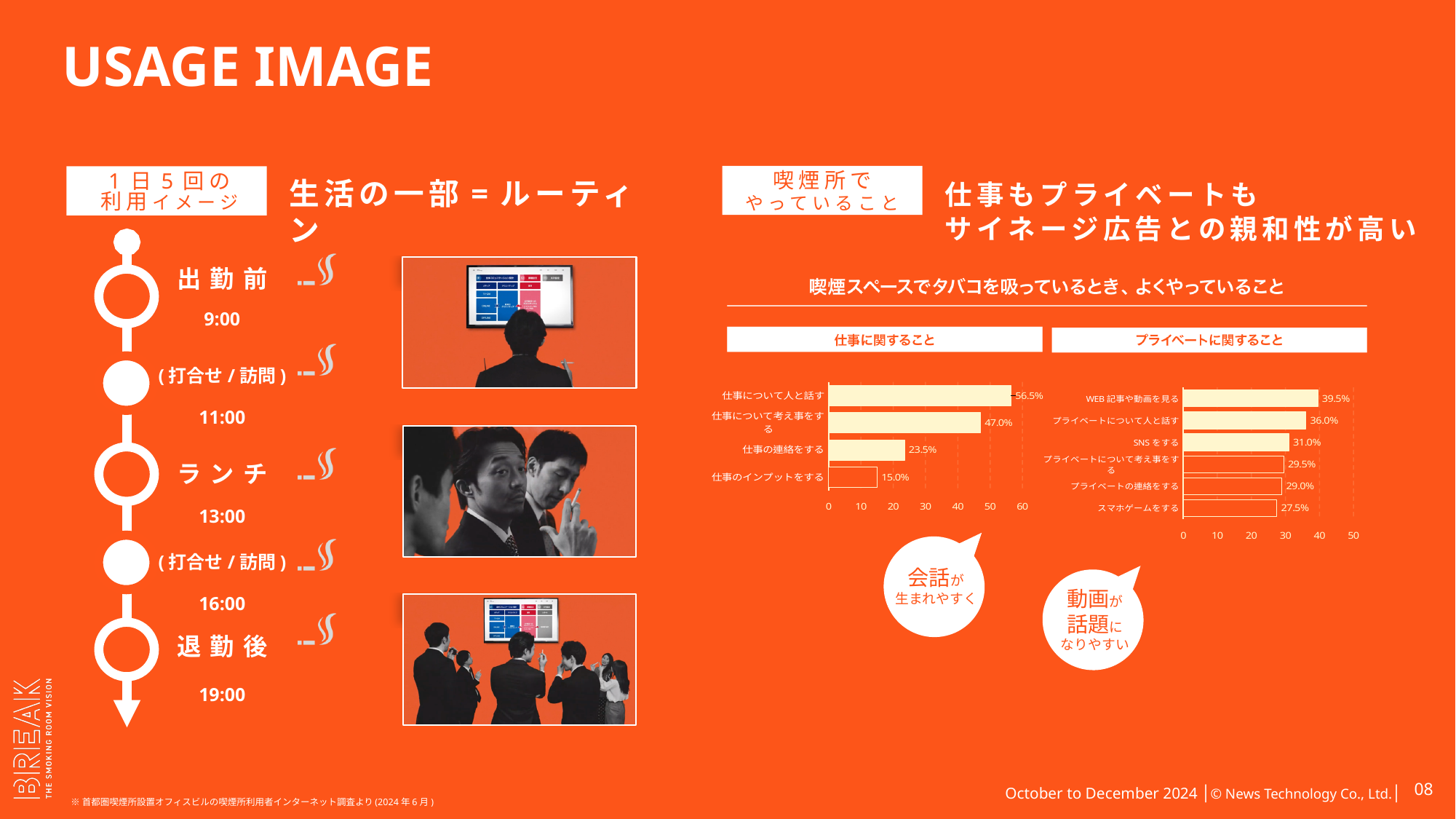
In the プライベートに関すること chart, what is the value for SNS をする? 31.0% In the プライベートに関すること chart, what is the value for スマホゲームをする? 27.5% In the 仕事に関すること chart, what is the value for 仕事のインプットをする? 15.0% How many categories are shown in the 仕事に関すること chart? 4 What is the title shown above the two charts? 喫煙スペースでタバコを吸っているとき、よくやっていること In the プライベートに関すること chart, which category has the lowest value? スマホゲームをする In the 仕事に関すること chart, which category has the highest value? 仕事について人と話す In the プライベートに関すること chart, which is larger: WEB 記事や動画を見る or プライベートについて人と話す? WEB 記事や動画を見る In the 仕事に関すること chart, what is the value for 仕事について人と話す? 56.5% In the 仕事に関すること chart, what is the difference between 仕事について人と話す and 仕事について考え事をする? 9.5% What type of chart is the 仕事に関すること chart? Bar chart How many categories are shown in the プライベートに関すること chart? 6